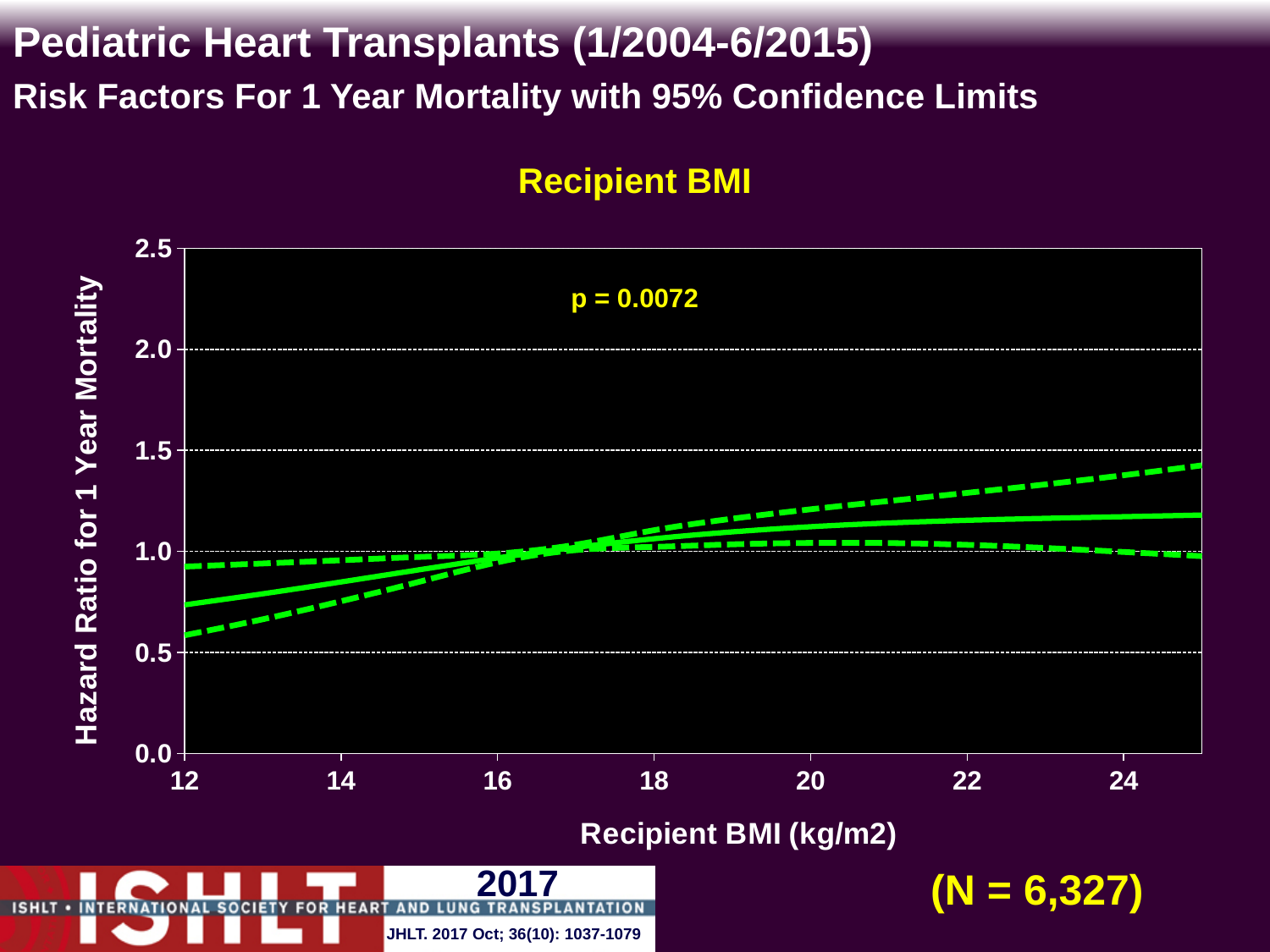
Is the hazard ratio (solid line) at a Recipient BMI of 24 greater or less than 1.0? greater Is the hazard ratio (solid line) at a Recipient BMI of 12 greater or less than 1.0? less Is the lower confidence limit (lower dashed line) at a Recipient BMI of 12 greater or less than 0.5? greater What p-value is printed on the chart? p = 0.0072 How many lines are plotted on the chart? 3 Does the solid hazard ratio line rise or fall as Recipient BMI increases from 12 to 24? rise Is the hazard ratio (solid line) higher at a Recipient BMI of 24 or at a Recipient BMI of 12? 24 What kind of chart is shown on the slide? line chart What is the label of the y-axis? Hazard Ratio for 1 Year Mortality